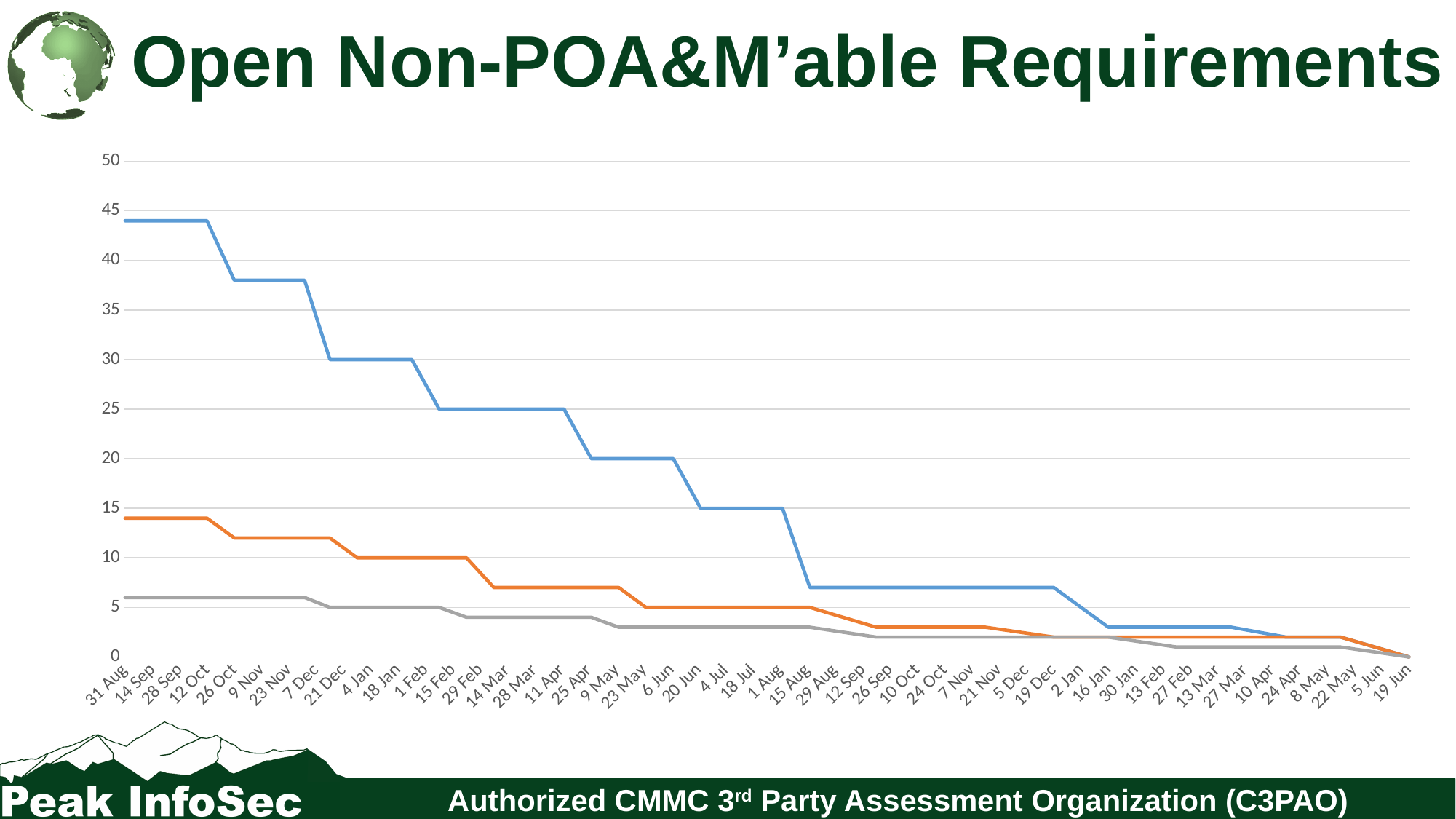
What is the value of the blue line at 21 Dec? 30 Do the plotted values generally rise or fall from left to right along the x axis? fall How many lines are plotted on the chart? 3 What value do all three lines reach at 19 Jun? 0 Is the value of the orange line at 31 Aug greater or less than 15? less What is the title of the chart on the slide? Open Non-POA&M'able Requirements Is the value of the blue line at 31 Aug greater or less than 40? greater Which line has the highest value at 31 Aug? the blue line What kind of chart is shown on the slide? line chart What is the value of the orange line at 4 Jan? 10